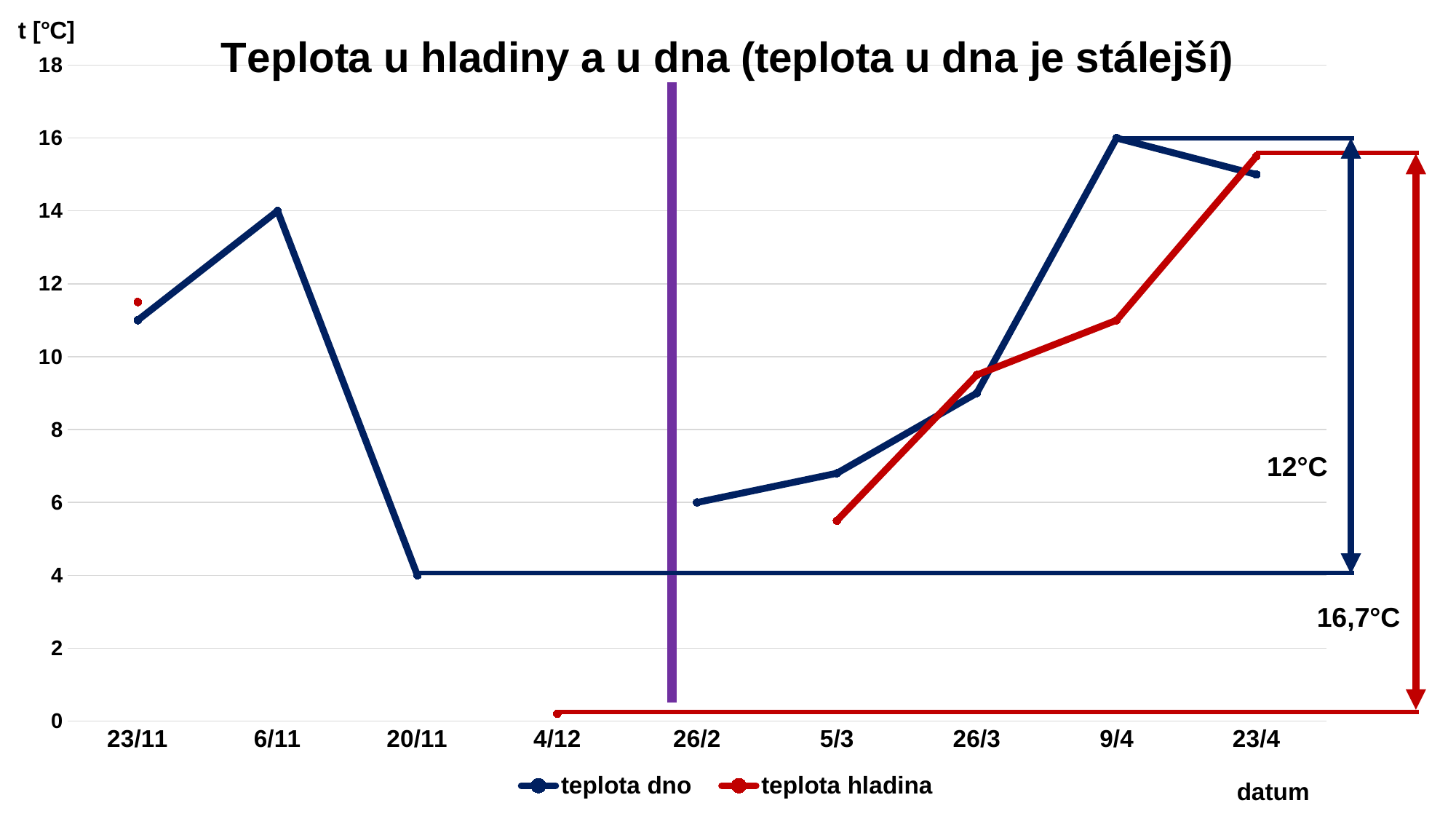
What is the value of teplota dno on 9/4? 16 How many dates are shown on the x axis? 9 Is the value of teplota hladina on 9/4 greater or less than 12? less On 9/4, which series has the higher value, teplota dno or teplota hladina? teplota dno What is the value of teplota dno on 6/11? 14 What kind of chart is shown on the slide? line chart On which date is teplota dno highest? 9/4 What is the value of teplota dno on 20/11? 4 What is the difference between teplota dno on 9/4 and on 20/11? 12 Does teplota hladina rise or fall from 5/3 to 23/4? rise How many series does the legend list? 2 On which date is teplota dno lowest? 20/11